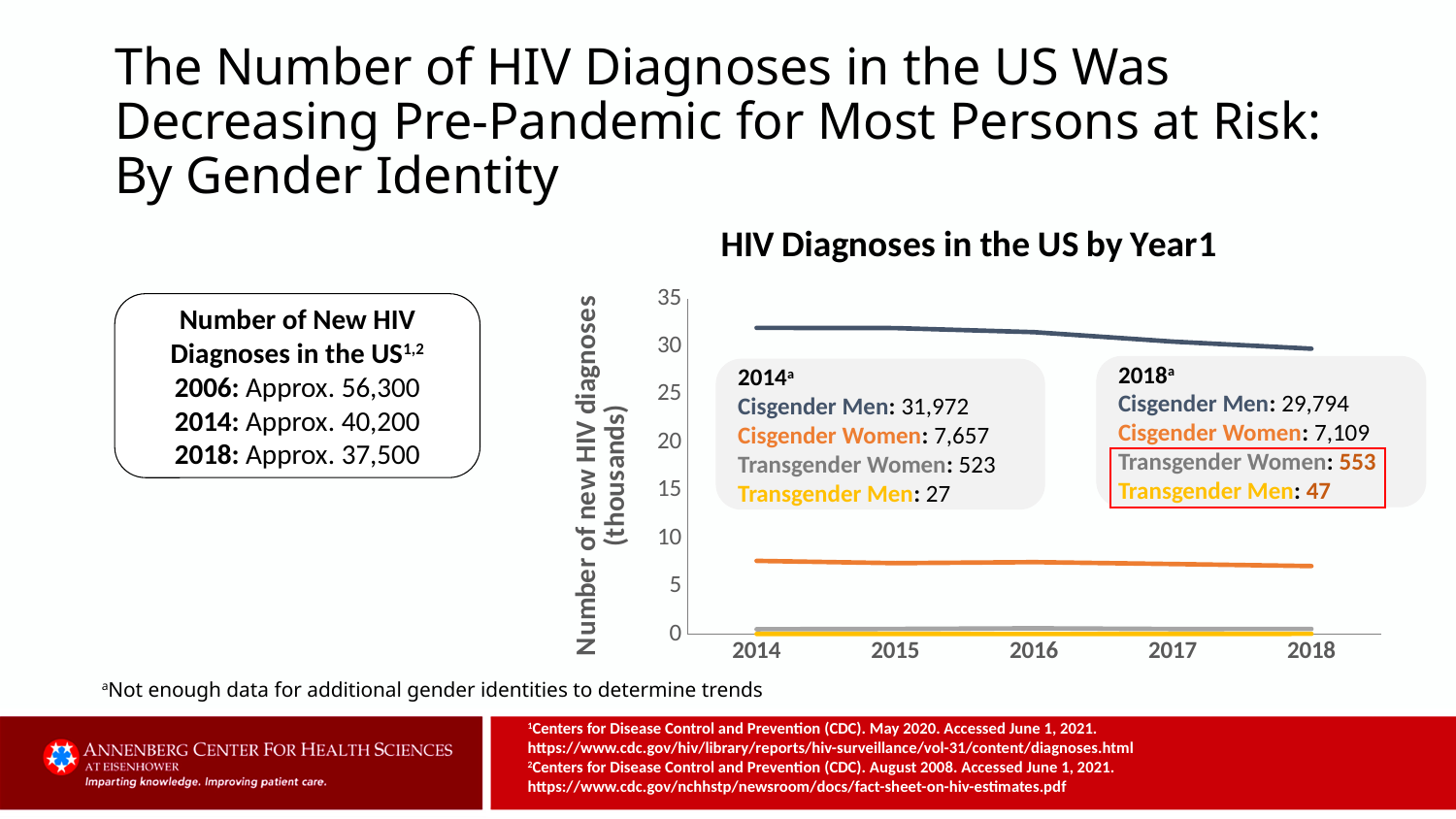
Does the Cisgender Men line rise or fall from 2014 to 2018? Fall What was the number of HIV diagnoses among Transgender Men in 2018? 47 By how much did HIV diagnoses among Cisgender Men decrease from 2014 to 2018? 2,178 Which gender identity group had the highest number of HIV diagnoses in 2018? Cisgender Men What was the number of HIV diagnoses among Transgender Women in 2014? 523 How many years are shown on the x axis of the chart? 5 What was the number of HIV diagnoses among Cisgender Men in 2014? 31,972 Which gender identity group had the lowest number of HIV diagnoses in 2014? Transgender Men What is the title of the chart? HIV Diagnoses in the US by Year1 What is the difference between Transgender Women diagnoses in 2018 and 2014? 30 What kind of chart is shown on the slide? Line chart What was the number of HIV diagnoses among Cisgender Women in 2018? 7,109